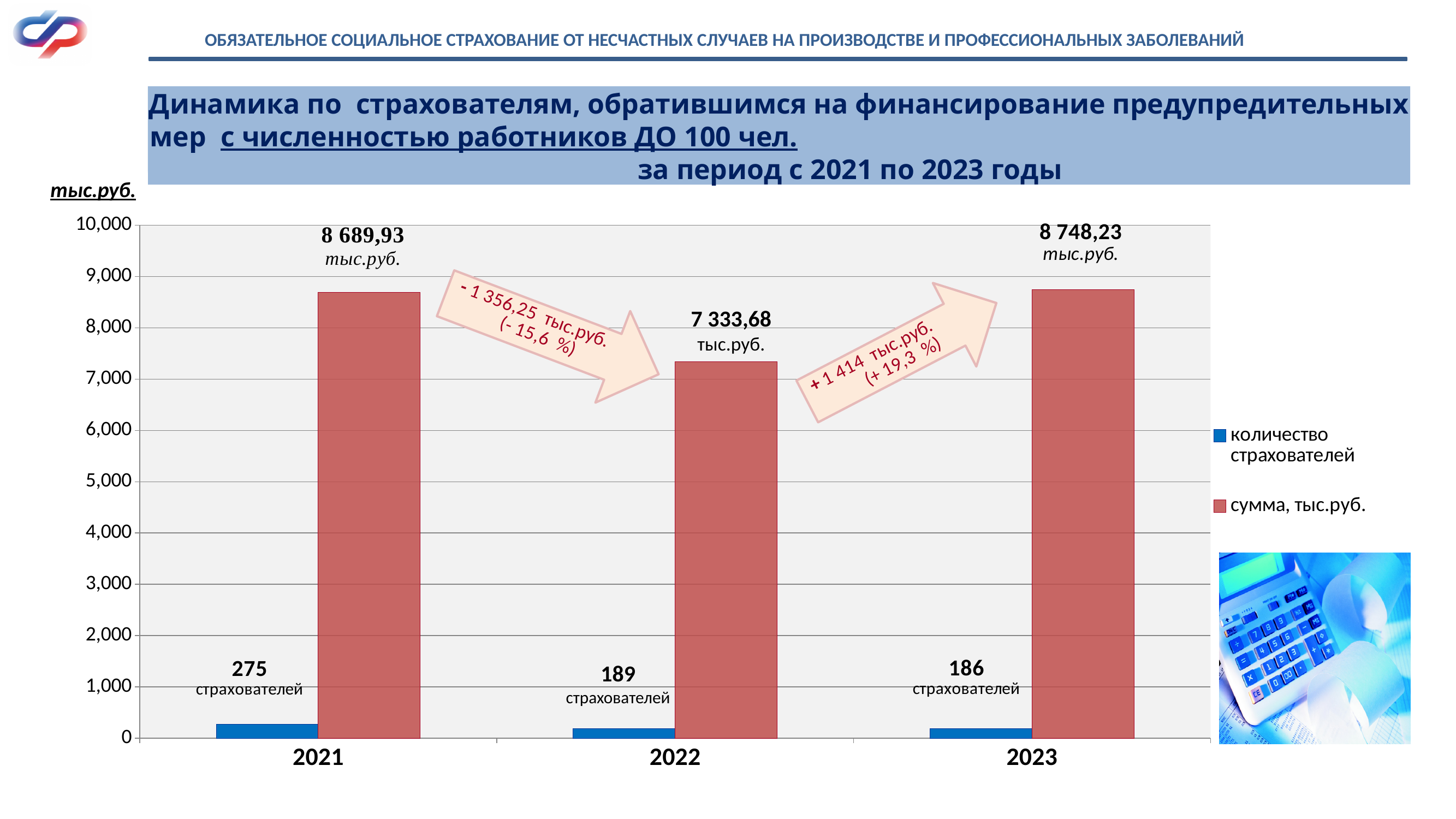
In which year is the сумма, тыс.руб. value the lowest? 2022 How many страхователей are shown for 2023? 186 What kind of chart is shown on the slide? bar chart How many series does the legend list? 2 What is the value of the сумма, тыс.руб. series for 2022? 7 333,68 What is the difference between the number of страхователей in 2021 and 2022? 86 How many страхователей are shown for 2021? 275 In which year is the сумма, тыс.руб. value the highest? 2023 In which year is the количество страхователей the highest? 2021 What is the value of the сумма, тыс.руб. series for 2021? 8 689,93 Which is larger: the сумма, тыс.руб. value for 2021 or for 2023? 2023 What is the difference between the сумма, тыс.руб. values for 2021 and 2022? 1 356,25